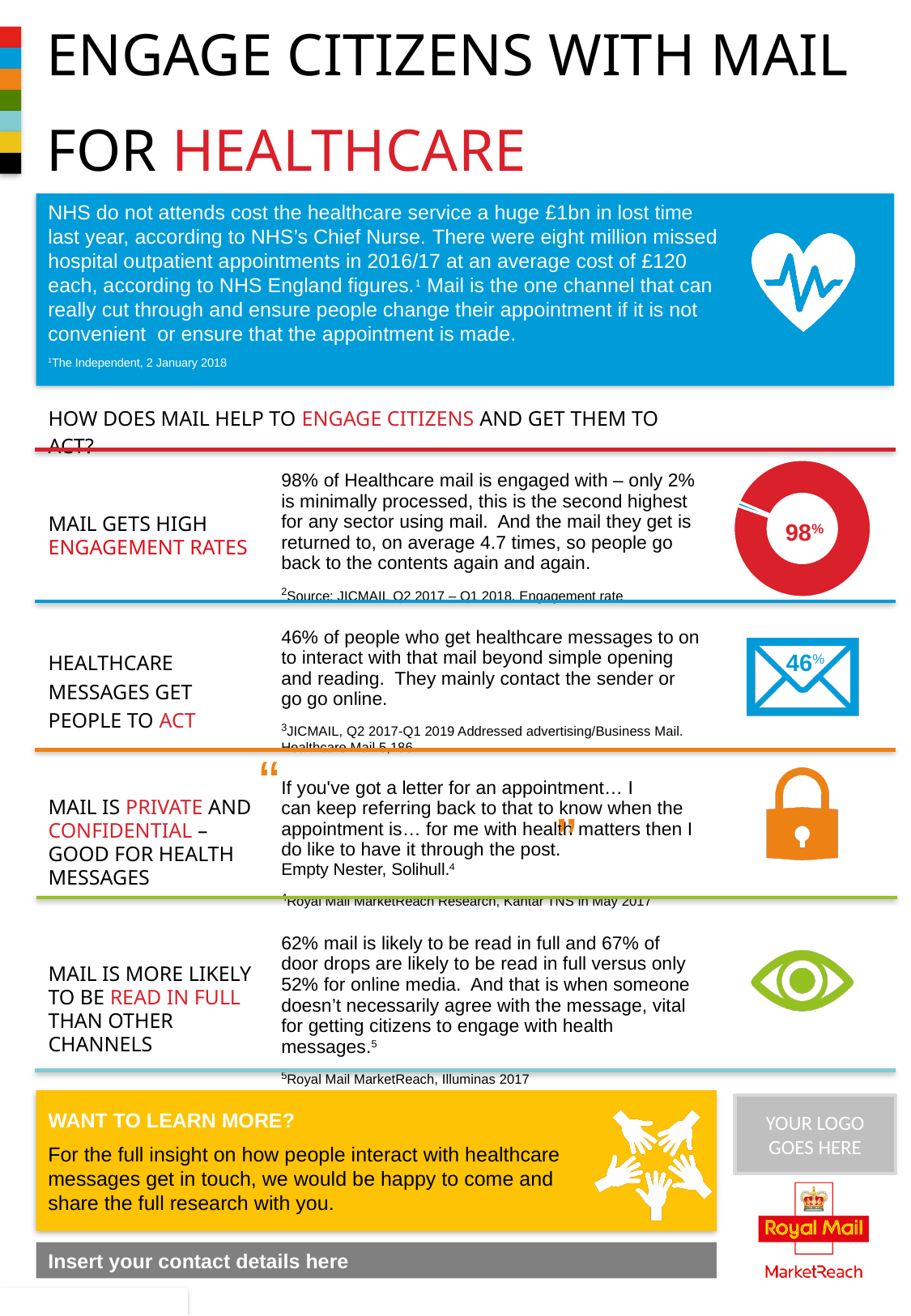
Which section of the slide does the doughnut chart illustrate? Mail gets high engagement rates Is the value shown in the doughnut chart greater or less than 50%? greater Which segment of the doughnut chart is larger, the red one or the blue one? The red one What share of the doughnut chart does the red segment represent? 98% How many segments does the doughnut chart have? 2 What percentage is printed in the centre of the doughnut chart? 98% What colour is the largest segment of the doughnut chart? Red What kind of chart is shown next to the 'Mail gets high engagement rates' section? Doughnut chart